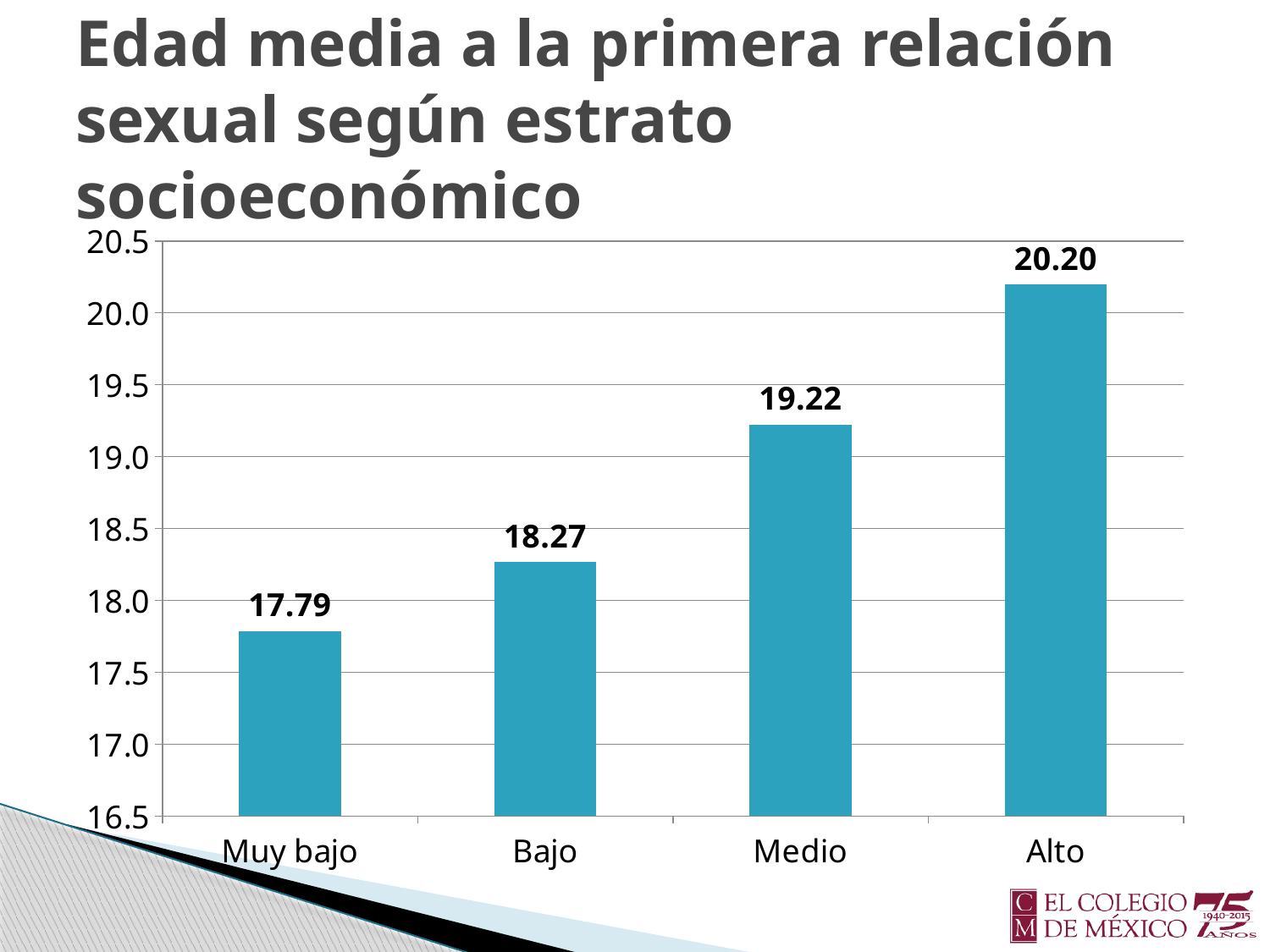
What is the difference between the values for Medio and Bajo? 0.95 What kind of chart is shown on the slide? Bar chart What is the value for Medio? 19.22 What is the value for Alto? 20.20 Which is larger, the value for Bajo or the value for Medio? Medio Which category has the lowest value? Muy bajo Do the values rise or fall from Muy bajo to Alto along the x axis? Rise What is the difference between the values for Alto and Muy bajo? 2.41 What is the value for Bajo? 18.27 What is the value for Muy bajo? 17.79 Which category has the highest value? Alto How many categories are shown on the x axis? 4